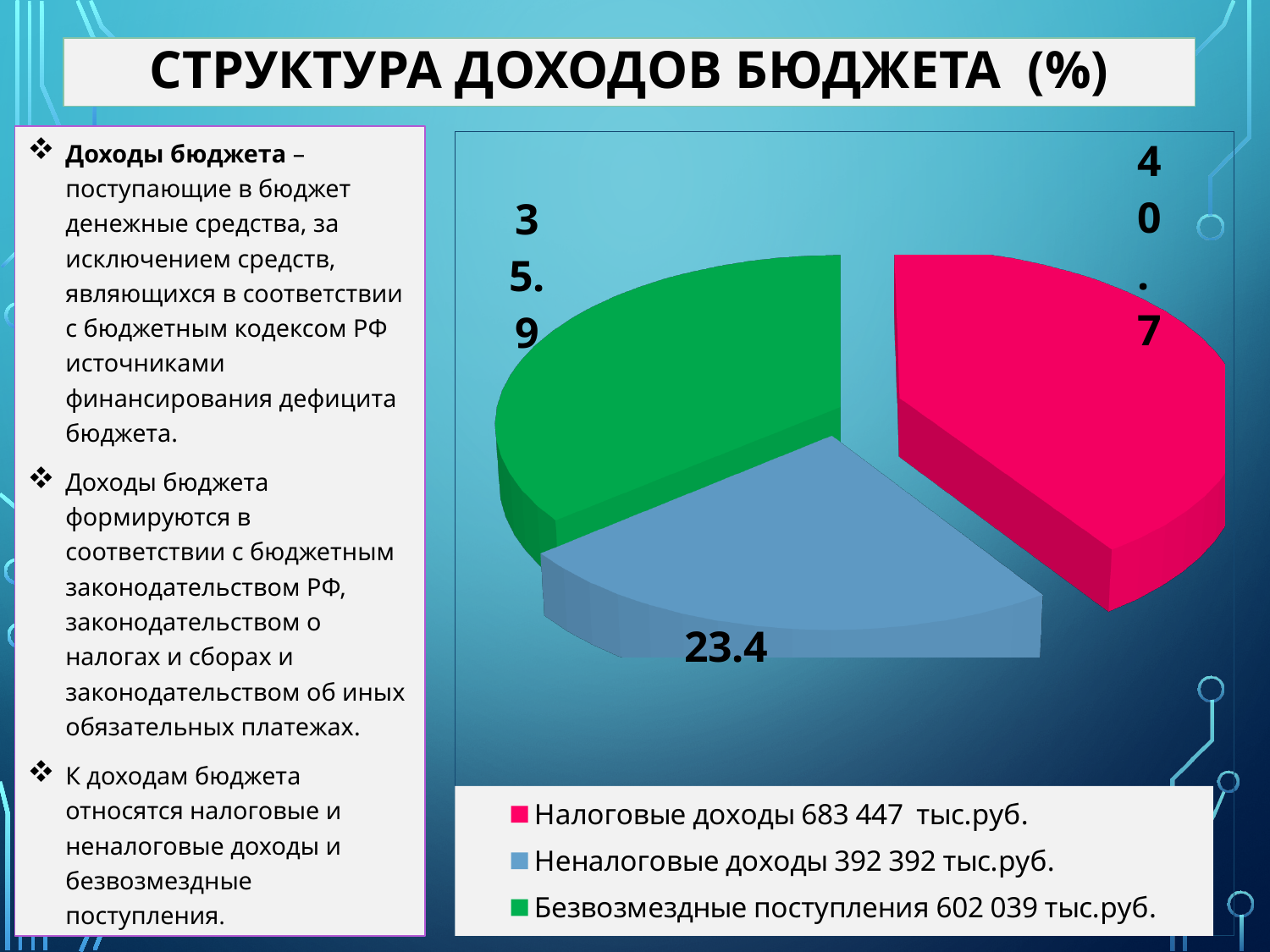
What percentage is shown for Безвозмездные поступления? 35.9 How many slices does the pie chart have? 3 What percentage is shown for Налоговые доходы? 40.7 What kind of chart is shown on the slide? Pie chart Is the share for Налоговые доходы greater or less than 50? less What percentage is shown for Неналоговые доходы? 23.4 Which category has the smallest share of the pie? Неналоговые доходы What is the title of the chart on the slide? СТРУКТУРА ДОХОДОВ БЮДЖЕТА (%) What is the difference in percentage points between Налоговые доходы and Неналоговые доходы? 17.3 What amount in тыс.руб. does the legend give for Безвозмездные поступления? 602 039 тыс.руб. Which is larger: the share for Безвозмездные поступления or the share for Неналоговые доходы? Безвозмездные поступления Which category has the largest share of the pie? Налоговые доходы